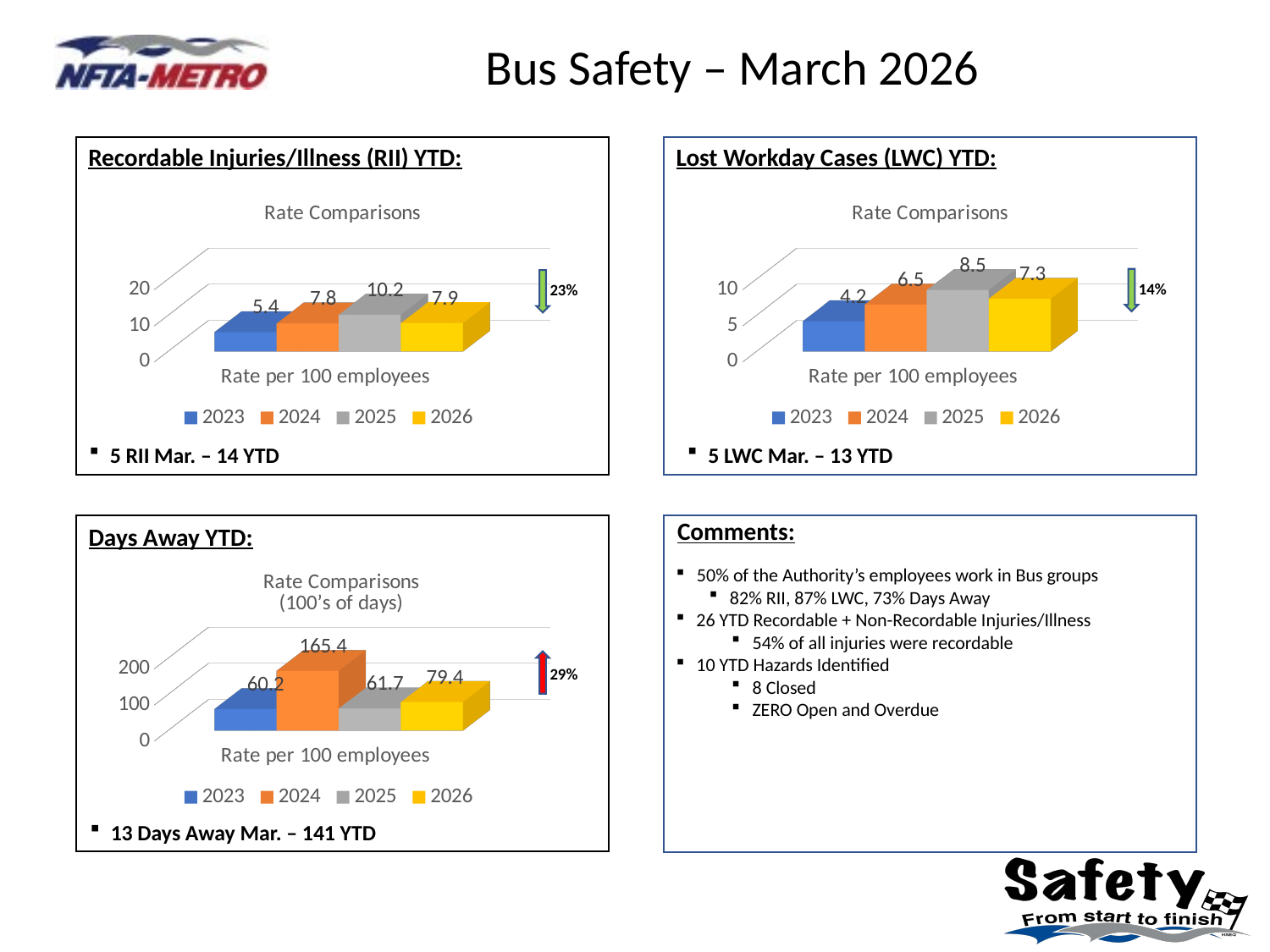
In the Recordable Injuries/Illness (RII) YTD chart, what is the value for 2025? 10.2 In the Lost Workday Cases (LWC) YTD chart, what is the value for 2026? 7.3 In the Recordable Injuries/Illness (RII) YTD chart, which year has the lowest rate? 2023 What is the x-axis category label shown in the Recordable Injuries/Illness (RII) YTD chart? Rate per 100 employees In the Lost Workday Cases (LWC) YTD chart, is the value for 2024 larger or smaller than the value for 2026? smaller In the Days Away YTD chart, what is the value for 2024? 165.4 In the Days Away YTD chart, which year has the highest value? 2024 What kind of chart is the Lost Workday Cases (LWC) YTD chart? bar chart In the Days Away YTD chart, what is the difference between the 2026 and 2023 values? 19.2 In the Recordable Injuries/Illness (RII) YTD chart, what is the difference between the 2025 and 2026 values? 2.3 In the Lost Workday Cases (LWC) YTD chart, which year has the highest rate? 2025 How many series does the legend of the Days Away YTD chart list? 4